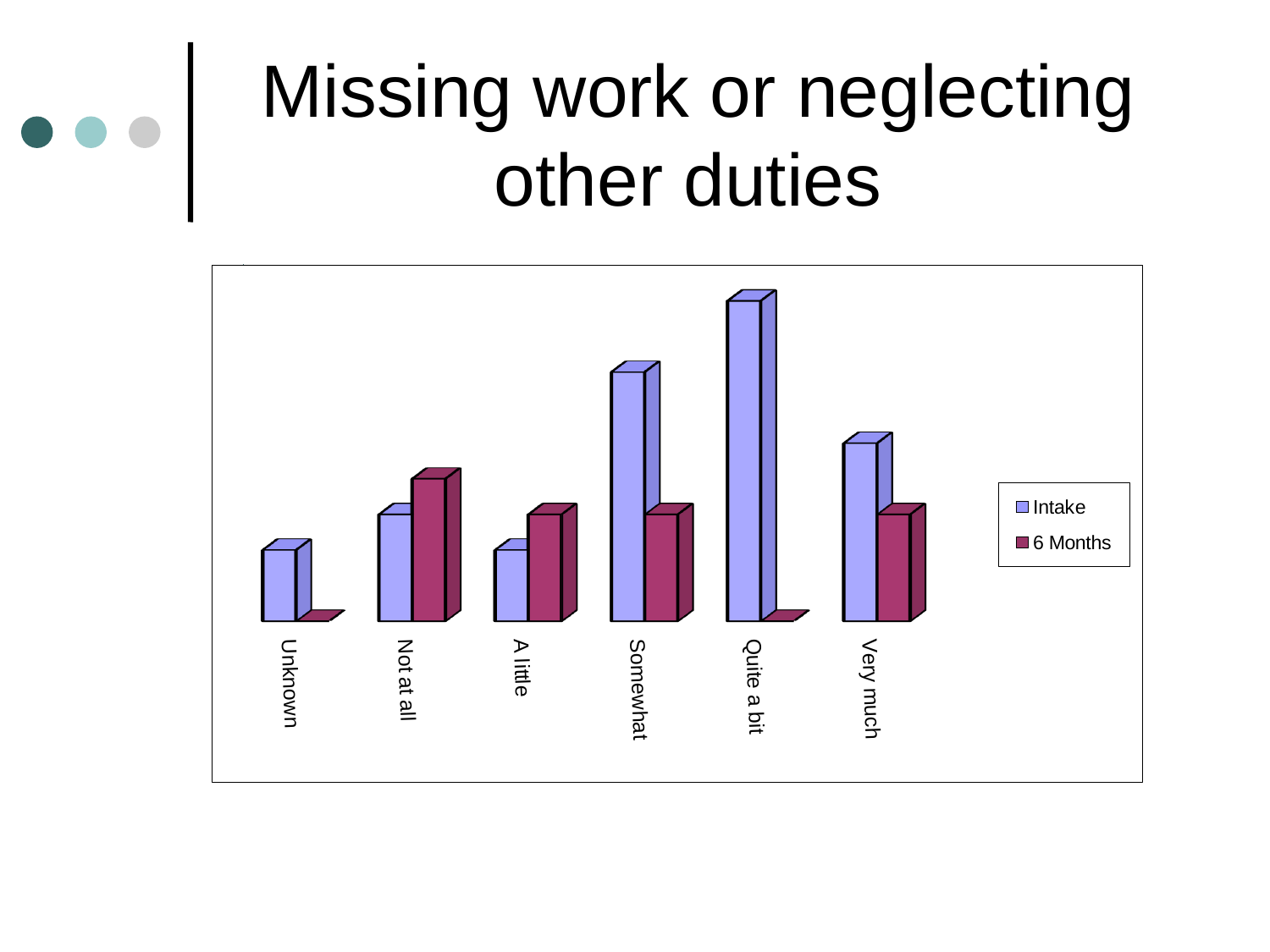
Which category has the highest Intake value? Quite a bit Which category has the highest 6 Months value? Not at all What kind of chart is shown on the slide? Bar chart For the 'Quite a bit' category, which is larger: Intake or 6 Months? Intake For the 'Very much' category, which is larger: Intake or 6 Months? Intake Which is larger for the Intake series: 'Somewhat' or 'Very much'? Somewhat What is the title of the slide containing the chart? Missing work or neglecting other duties How many series does the chart's legend list? 2 How many categories are shown on the x axis of the chart? 6 What are the two series named in the chart's legend? Intake and 6 Months